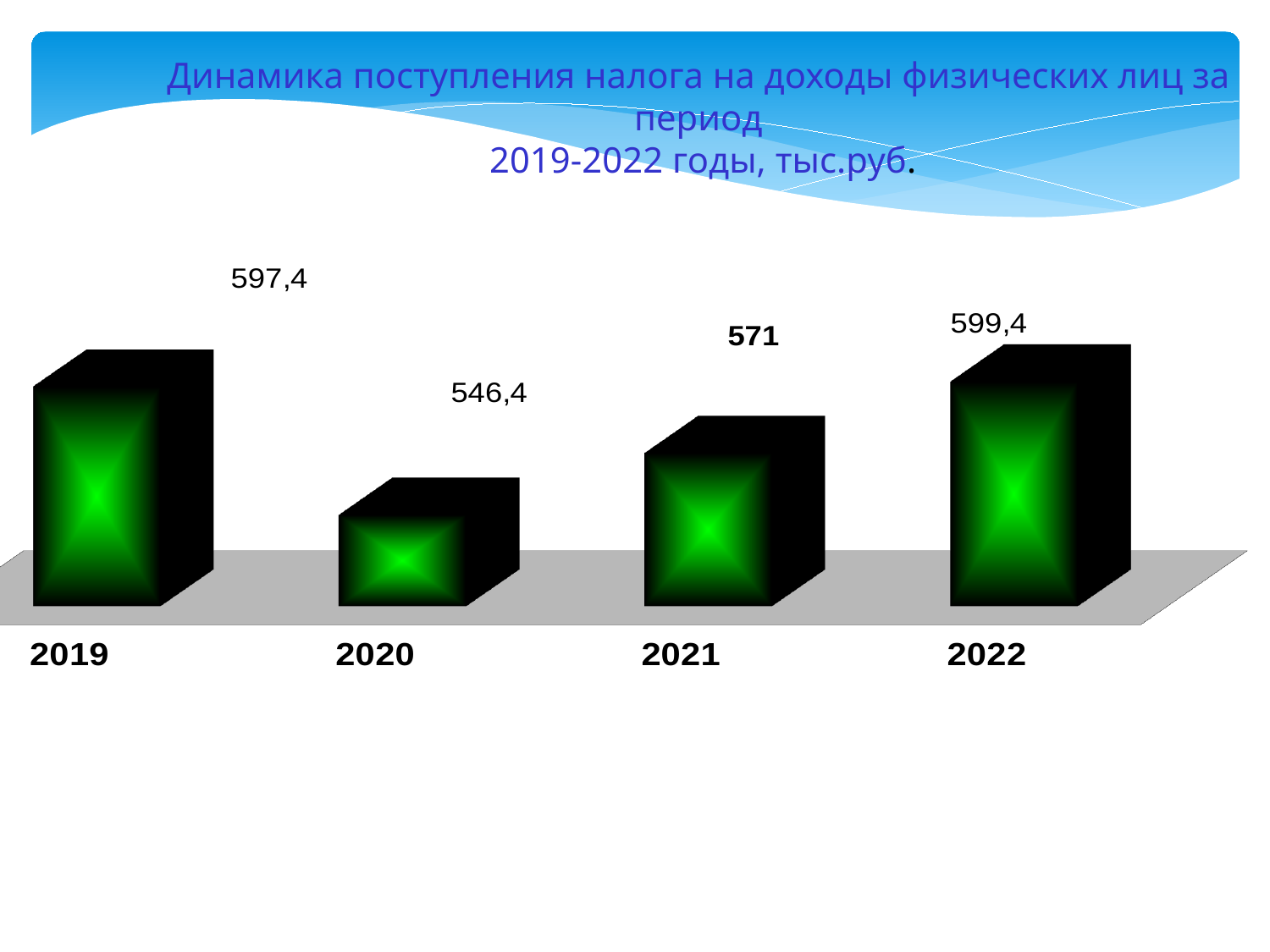
What is the value for 2019? 597,4 Which year has the lowest value? 2020 How many years are shown on the chart? 4 What is the value for 2020? 546,4 Which year has the highest value? 2022 Which is larger, the value for 2021 or the value for 2020? 2021 What is the value for 2021? 571 What is the value for 2022? 599,4 What is the difference between the values for 2022 and 2021? 28,4 Do the values rise or fall from 2020 to 2022? Rise What kind of chart is shown on the slide? Bar chart What is the difference between the values for 2019 and 2020? 51